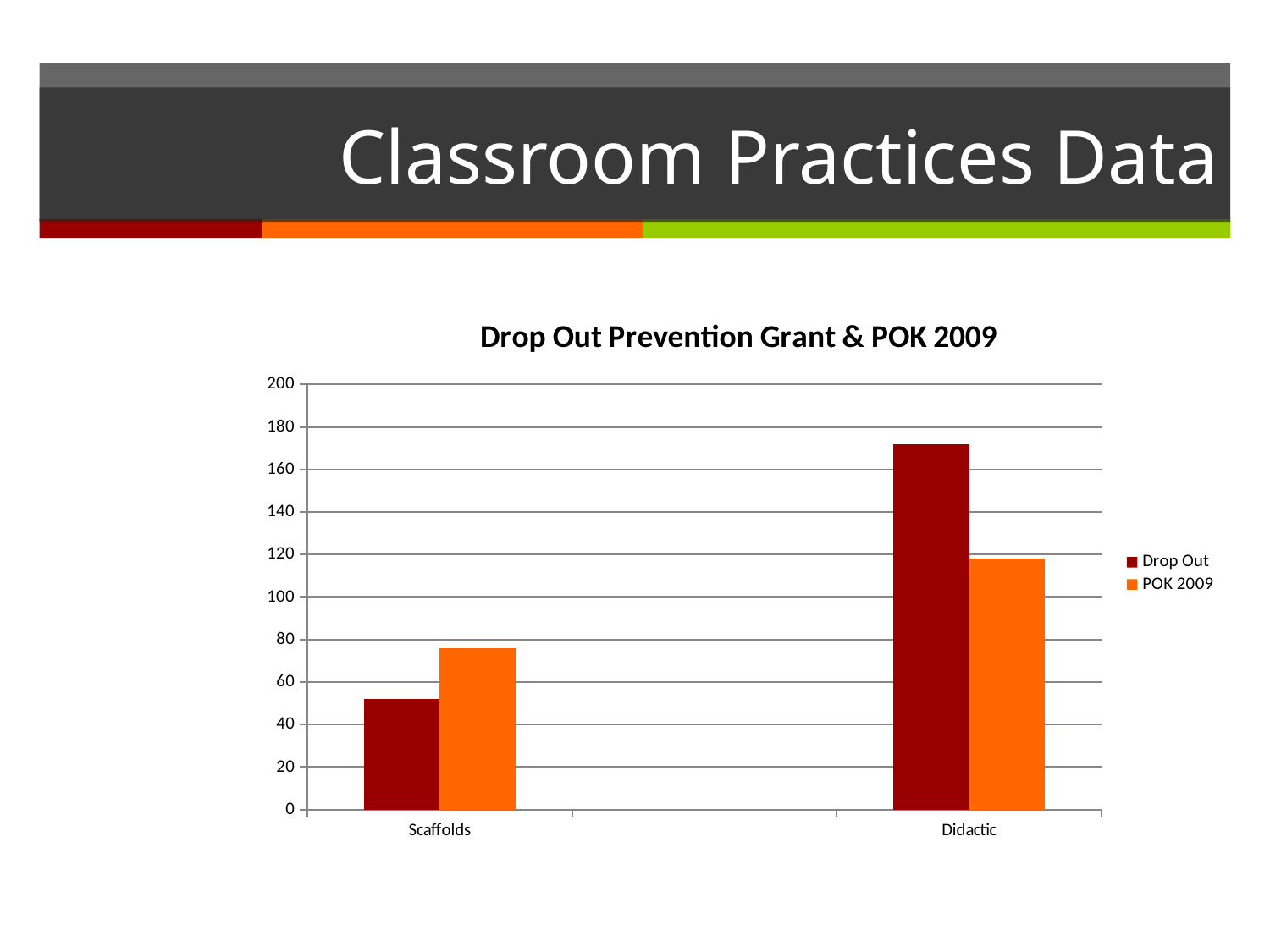
For Scaffolds, which series has the larger value, Drop Out or POK 2009? POK 2009 Is the Drop Out value for Scaffolds greater or less than 60? less How many categories are shown on the x axis? 2 Is the POK 2009 value for Scaffolds greater or less than 60? greater Is the POK 2009 value for Didactic greater or less than 100? greater Which category has the highest Drop Out value? Didactic What is the title of the chart? Drop Out Prevention Grant & POK 2009 For Didactic, which series has the larger value, Drop Out or POK 2009? Drop Out How many series does the legend list? 2 What kind of chart is shown on the slide? bar chart Which series is shown in orange? POK 2009